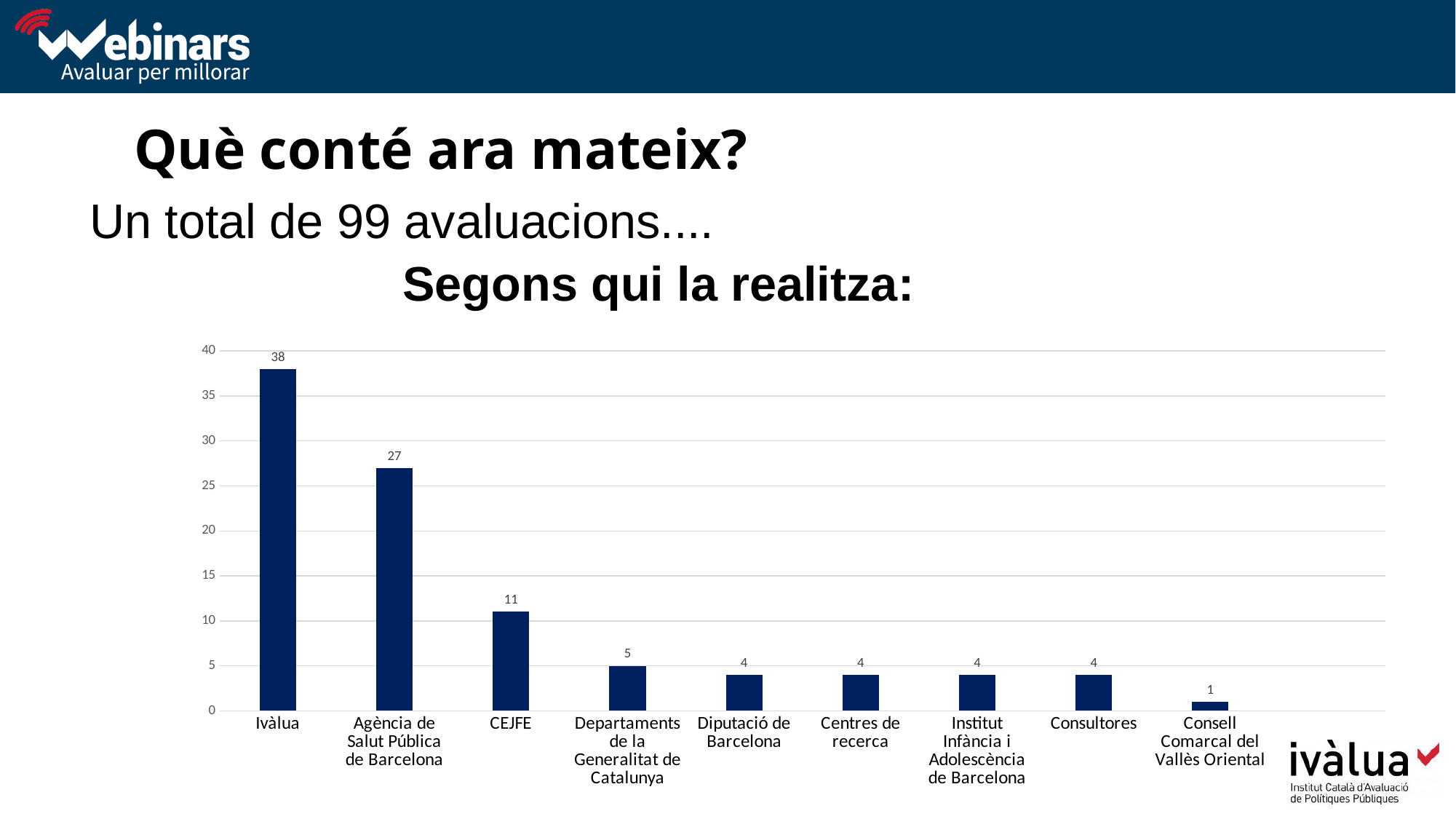
What kind of chart is shown on the slide? Bar chart Which is larger, the value for CEJFE or the value for Consultores? CEJFE What is the difference between the values for Ivàlua and Agència de Salut Pública de Barcelona? 11 What is the value for Ivàlua? 38 What is the title of the chart? Segons qui la realitza: Which category has the lowest value? Consell Comarcal del Vallès Oriental What is the value for Consell Comarcal del Vallès Oriental? 1 What is the value for Departaments de la Generalitat de Catalunya? 5 Which category has the highest value? Ivàlua What is the value for Agència de Salut Pública de Barcelona? 27 What is the value for CEJFE? 11 How many categories are shown on the x axis? 9